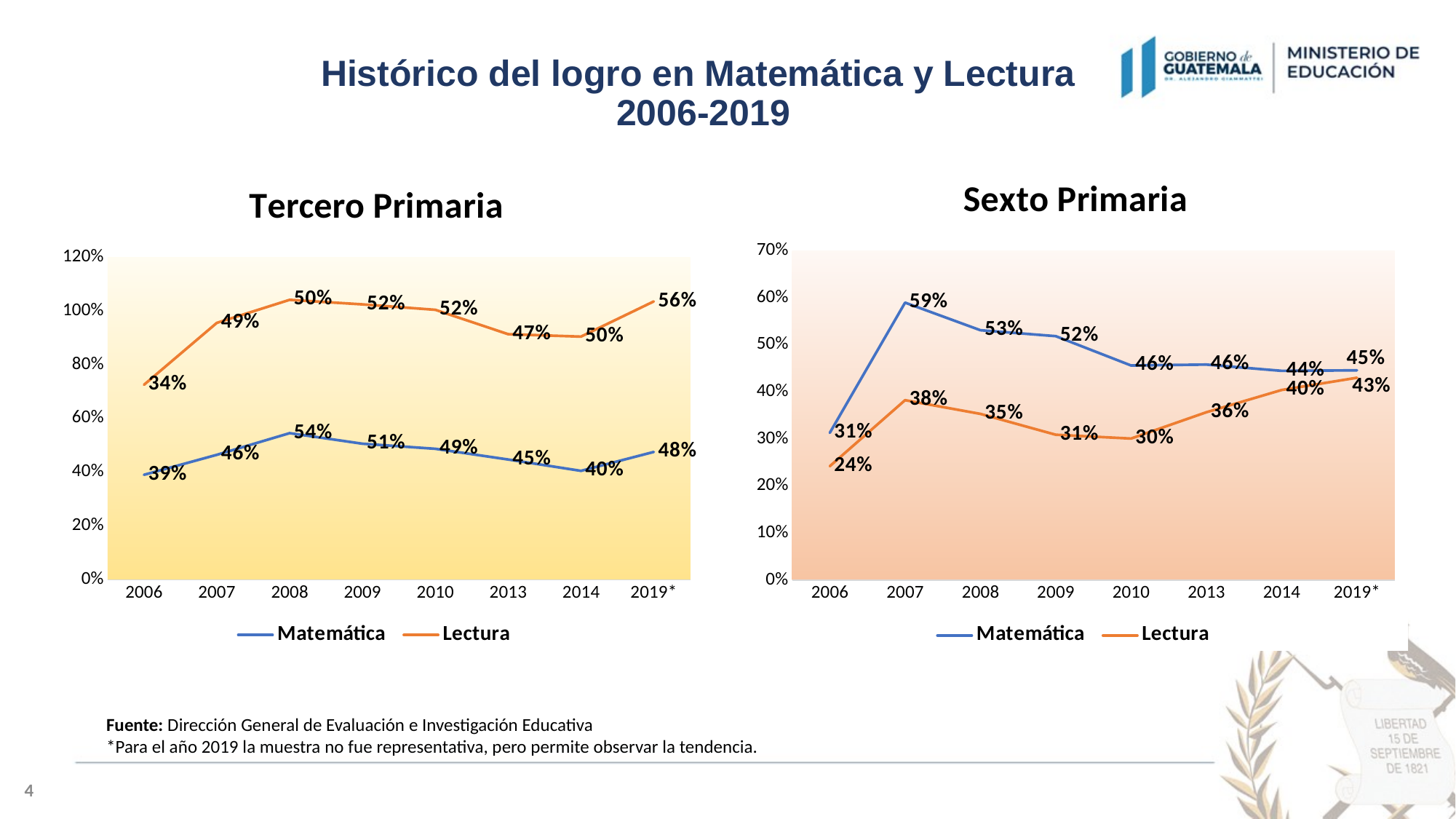
In the Sexto Primaria chart, does the Lectura value rise or fall from 2010 to 2019*? Rise In the Tercero Primaria chart, which year has the lowest Lectura value? 2006 In the Tercero Primaria chart, what is the Matemática value for 2008? 54% How many years are shown on the x axis of the Sexto Primaria chart? 8 In the Tercero Primaria chart, which is larger in 2014, Matemática or Lectura? Lectura How many series does the legend of the Tercero Primaria chart list? 2 What kind of chart is the Sexto Primaria chart? Line chart In the Sexto Primaria chart, what is the Matemática value for 2007? 59% In the Sexto Primaria chart, which year has the highest Matemática value? 2007 In the Sexto Primaria chart, what is the Lectura value for 2006? 24% In the Tercero Primaria chart, what is the Lectura value for 2019*? 56% In the Sexto Primaria chart, what is the difference between the Matemática and Lectura values for 2010? 16%